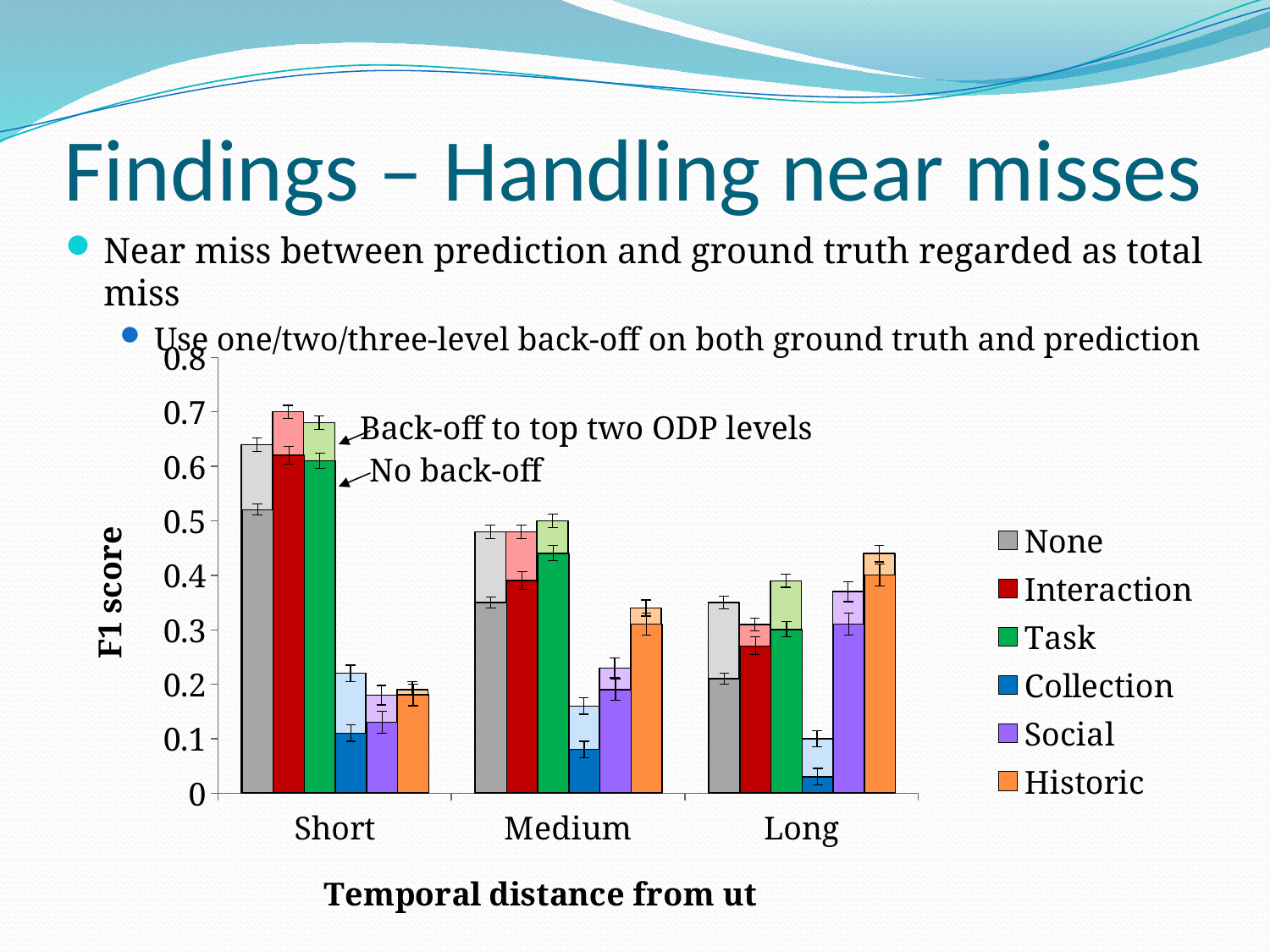
What kind of chart is shown on the slide? bar chart Which is larger in the Medium category, Historic or Collection? Historic Which series has the highest value in the Long category? Historic What is the title of the chart's x axis? Temporal distance from ut How many categories are shown on the x axis of the chart? 3 Which series has the lowest value in the Long category? Collection Do the values for Collection rise or fall from Short to Long? fall How many series does the chart's legend list? 6 Is the value for Collection in the Medium category greater or less than 0.2? less What is the title of the chart's y axis? F1 score Which series has the lowest value in the Medium category? Collection